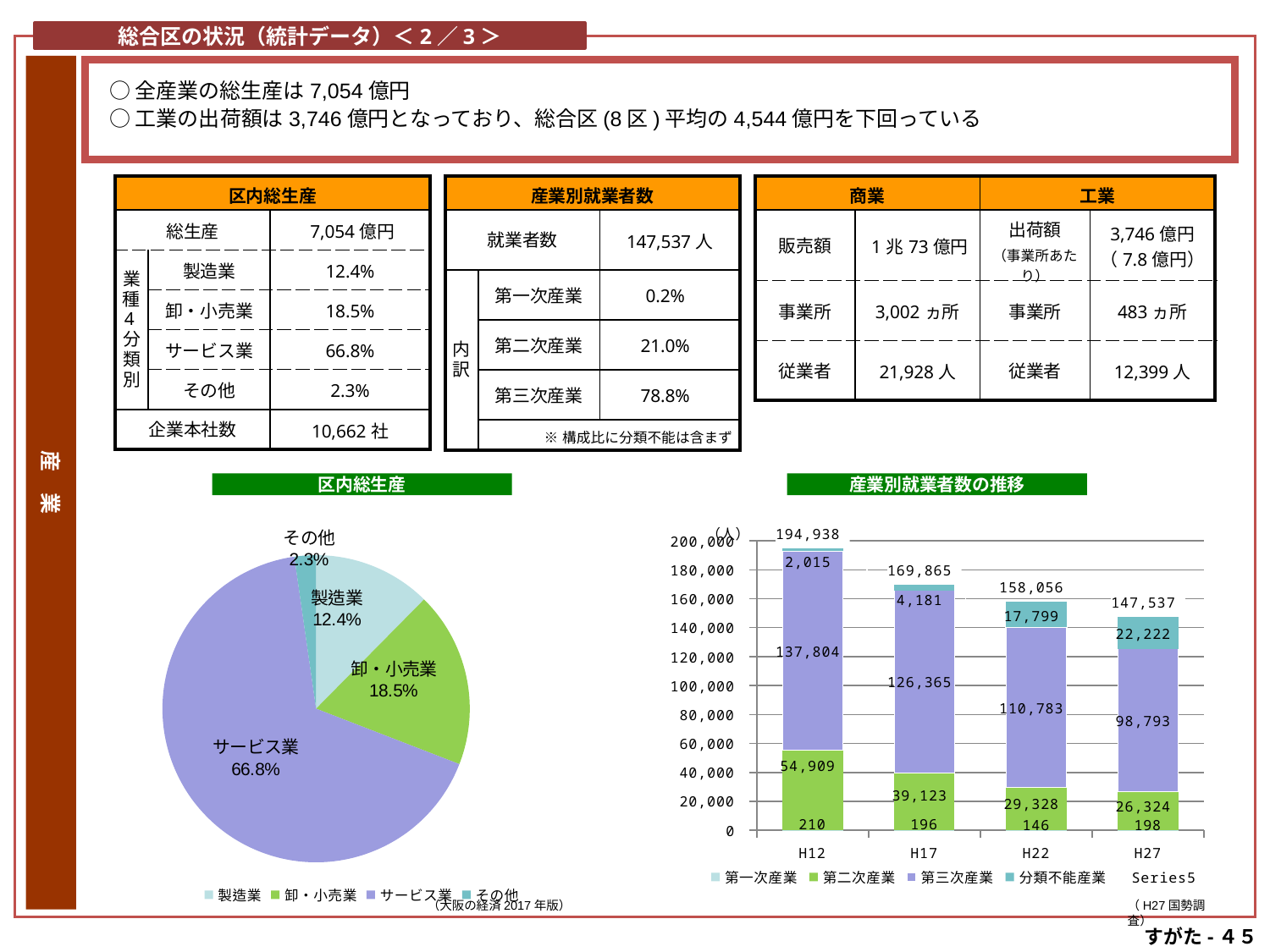
In the pie chart titled 区内総生産, how many slices are there? 4 In the chart titled 産業別就業者数の推移, what is the total for H12? 194,938 In the chart titled 産業別就業者数の推移, what kind of chart is it? Stacked bar chart In the chart titled 産業別就業者数の推移, what is the difference between the totals for H12 and H27? 47,401 In the chart titled 産業別就業者数の推移, what is the value of 分類不能産業 for H22? 17,799 In the pie chart titled 区内総生産, which category has the largest share? サービス業 In the chart titled 産業別就業者数の推移, do the totals rise or fall from H12 to H27? Fall In the pie chart titled 区内総生産, which category has the smallest share? その他 In the chart titled 産業別就業者数の推移, what is the value of 第二次産業 for H17? 39,123 In the pie chart titled 区内総生産, what share does サービス業 have? 66.8% In the chart titled 産業別就業者数の推移, what is the value of 第三次産業 for H27? 98,793 In the pie chart titled 区内総生産, what share does 卸・小売業 have? 18.5%